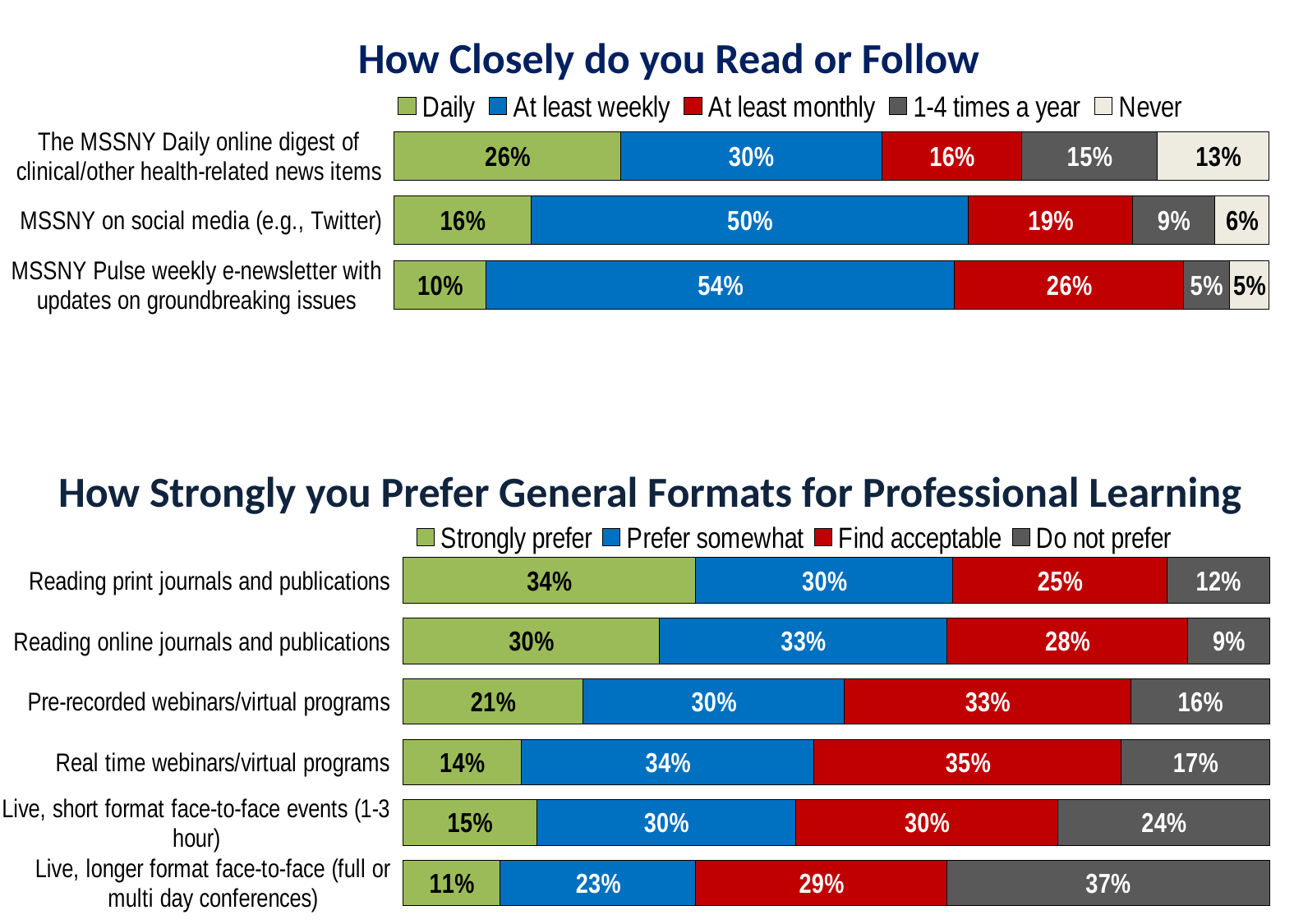
What type of chart is used for 'How Strongly you Prefer General Formats for Professional Learning'? Stacked bar chart In the 'How Closely do you Read or Follow' chart, what is the difference between the 'At least weekly' percentages for MSSNY on social media and the MSSNY Daily online digest? 20% In the 'How Closely do you Read or Follow' chart, what percentage never read the MSSNY Daily online digest? 13% In the 'How Closely do you Read or Follow' chart, which item has the highest 'Daily' percentage? The MSSNY Daily online digest of clinical/other health-related news items In the 'How Strongly you Prefer General Formats for Professional Learning' chart, how many formats are listed? 6 In the 'How Closely do you Read or Follow' chart, what percentage read the MSSNY Pulse weekly e-newsletter at least weekly? 54% In the 'How Strongly you Prefer General Formats for Professional Learning' chart, which is larger: the 'Find acceptable' percentage for real time webinars or for pre-recorded webinars? Real time webinars/virtual programs In the 'How Closely do you Read or Follow' chart, how many series does the legend list? 5 In the 'How Strongly you Prefer General Formats for Professional Learning' chart, which format has the highest 'Do not prefer' percentage? Live, longer format face-to-face (full or multi day conferences) In the 'How Strongly you Prefer General Formats for Professional Learning' chart, what percentage strongly prefer reading print journals and publications? 34% In the 'How Strongly you Prefer General Formats for Professional Learning' chart, what colour represents 'Find acceptable'? Red In the 'How Strongly you Prefer General Formats for Professional Learning' chart, which format has the lowest 'Strongly prefer' percentage? Live, longer format face-to-face (full or multi day conferences)